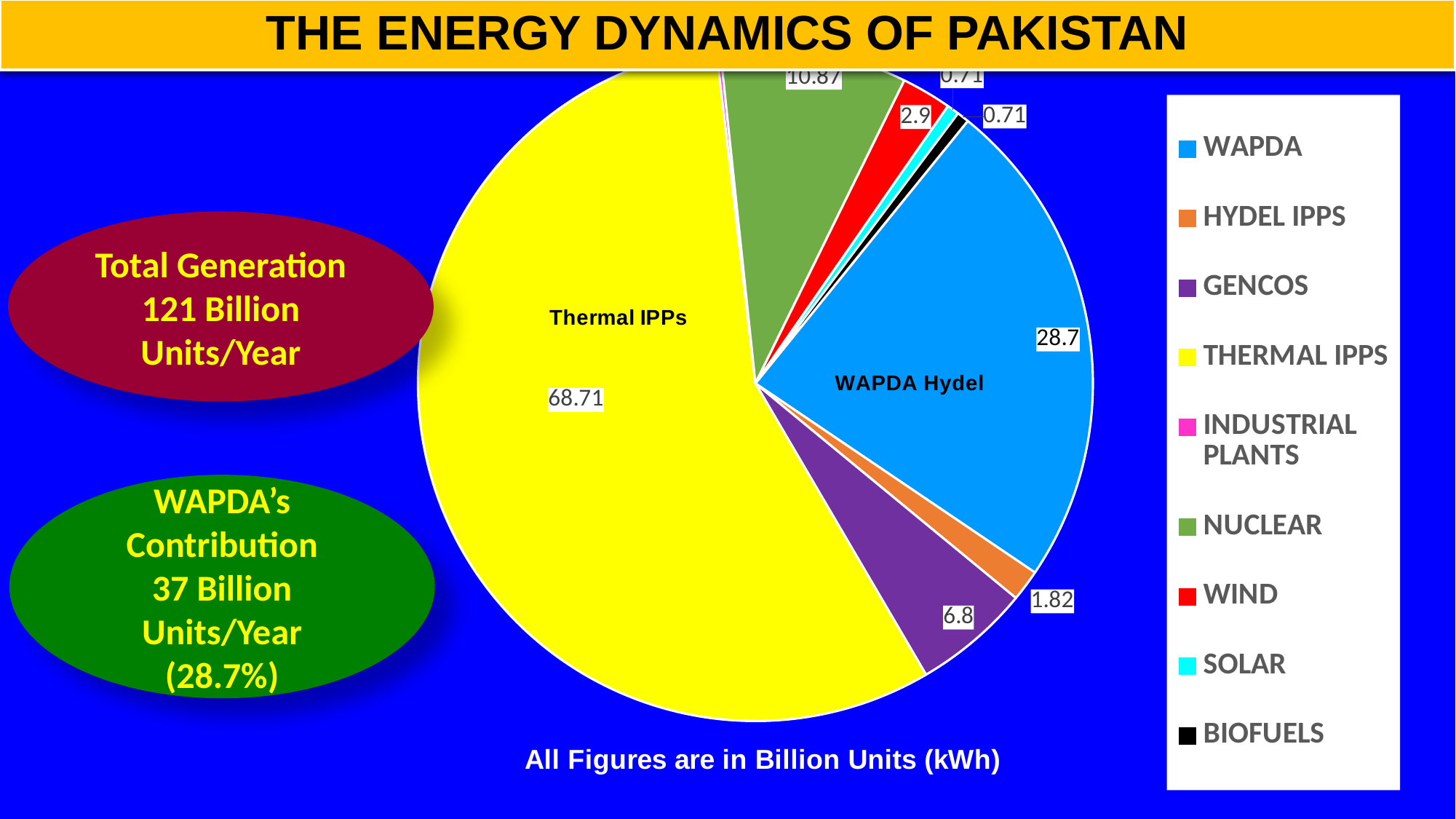
What is the value for Hydel IPPs? 1.82 What is the difference between the Thermal IPPs value and the WAPDA Hydel value? 40.01 What is the value for WAPDA Hydel? 28.7 Which is larger, the value for Nuclear or the value for GENCOS? Nuclear What colour is the Thermal IPPs slice? yellow What is the value for Thermal IPPs? 68.71 What kind of chart is shown on the slide? pie chart What is the value for Wind? 2.9 What is the value for Nuclear? 10.87 What is the value for GENCOS? 6.8 Which category has the largest slice of the pie? Thermal IPPs How many entries does the legend list? 9